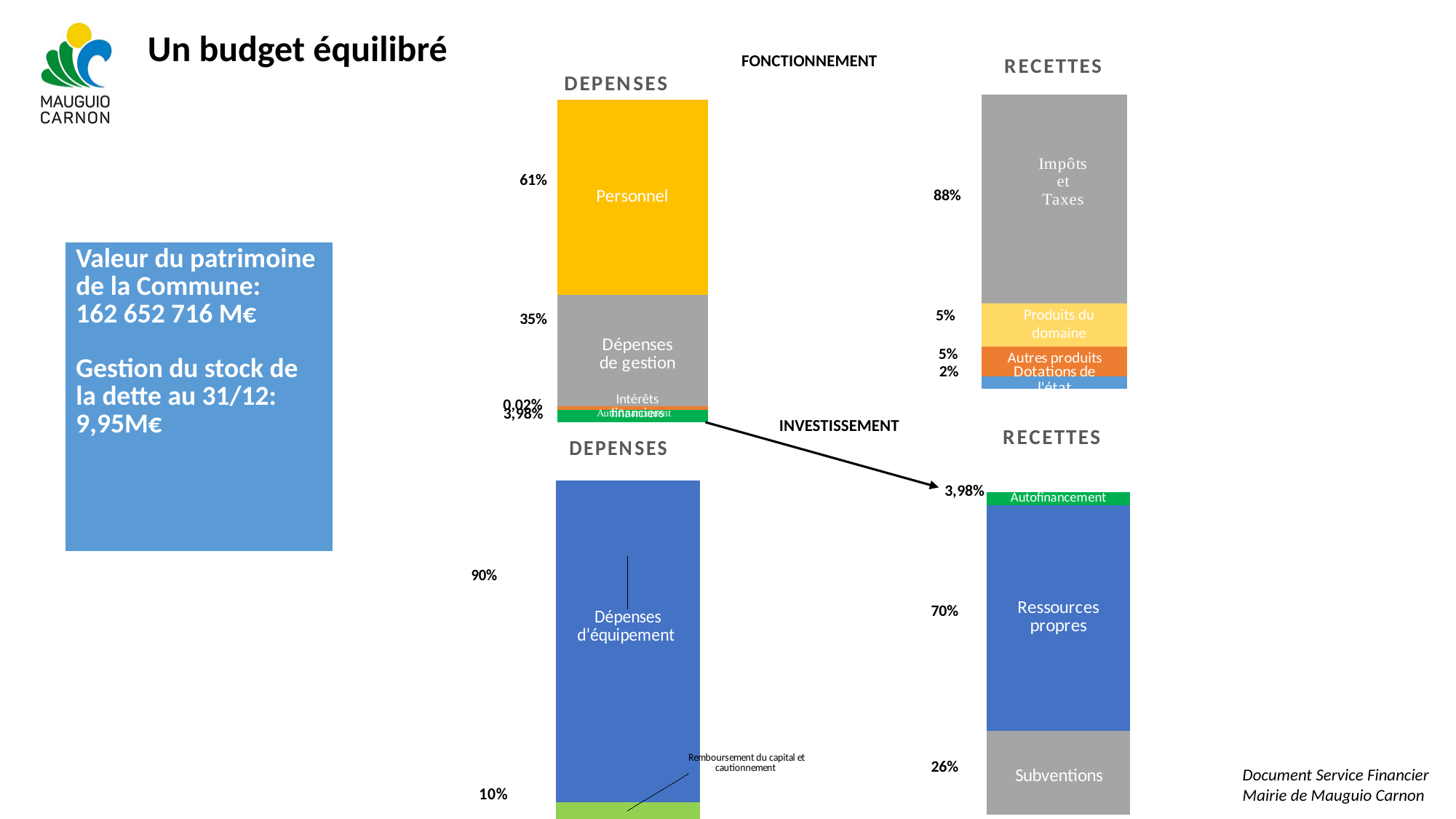
In the Investissement Dépenses chart, what percentage is shown for Dépenses d'équipement? 90% In the Fonctionnement Recettes chart, which segment is the smallest? Dotations de l'état In the Investissement Recettes chart, what percentage is shown for Autofinancement? 3,98% In the Fonctionnement Recettes chart, what percentage is shown for Dotations de l'état? 2% In the Fonctionnement Dépenses chart, what percentage is shown for Personnel? 61% What kind of chart is used for the Investissement Dépenses? Stacked bar chart In the Investissement Recettes chart, what is the difference between Ressources propres and Subventions? 44% In the Investissement Recettes chart, what percentage is shown for Subventions? 26% In the Fonctionnement Dépenses chart, which segment is the largest? Personnel In the Fonctionnement Dépenses chart, which is larger: Personnel or Dépenses de gestion? Personnel In the Fonctionnement Recettes chart, what percentage is shown for Impôts et Taxes? 88% In the Fonctionnement Dépenses chart, what percentage is shown for Dépenses de gestion? 35%